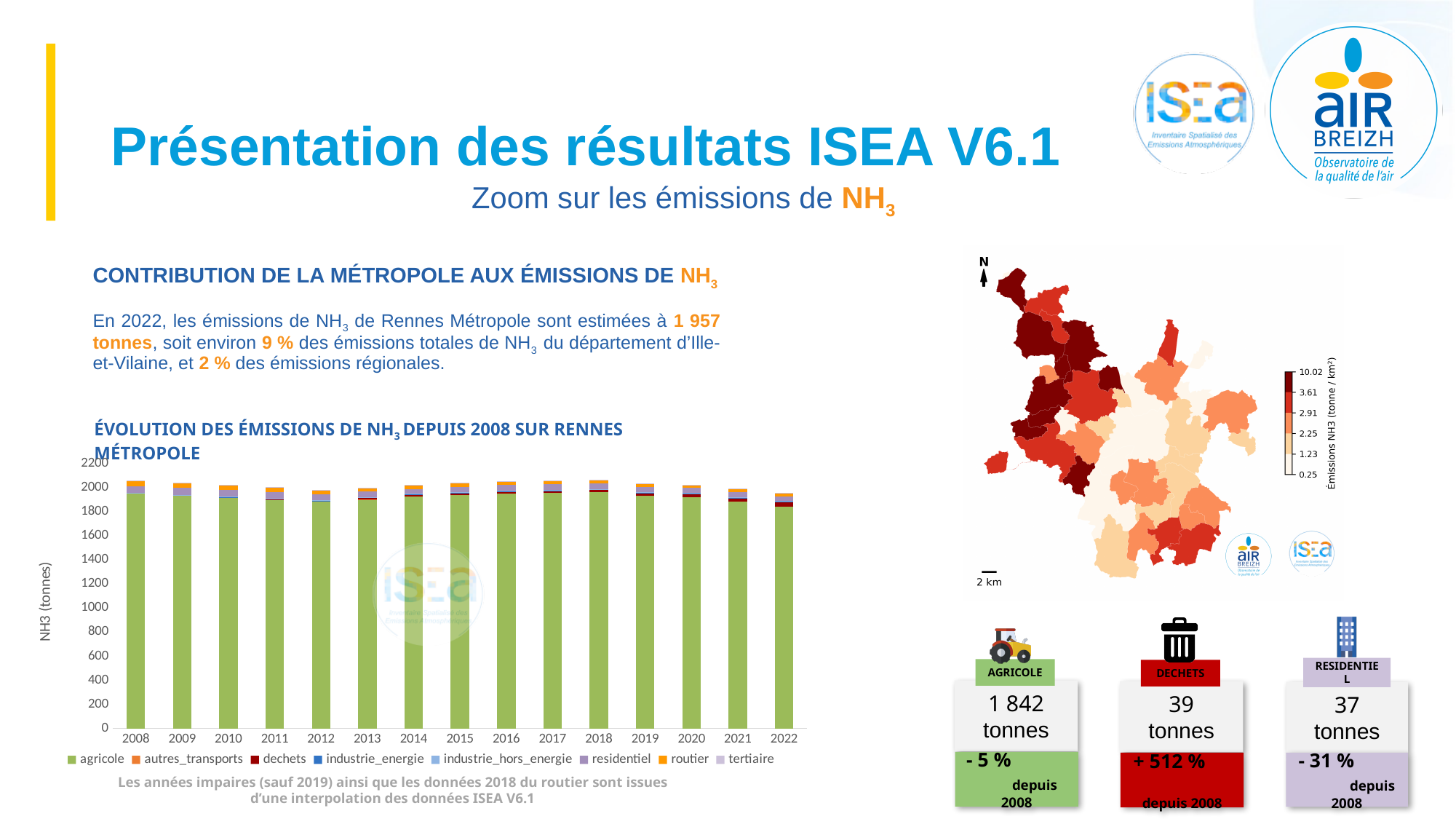
Which series makes up the largest part of each bar in the NH3 emissions evolution chart? agricole In the NH3 emissions evolution chart, is the agricole value for 2018 greater or less than 1400? greater In the NH3 emissions evolution chart, is the total for 2008 greater or less than 1800? greater How many years are shown on the x axis of the NH3 emissions evolution chart? 15 What is the label of the y axis of the NH3 emissions evolution chart? NH3 (tonnes) What is the highest tick value shown on the y axis of the NH3 emissions evolution chart? 2200 In the NH3 emissions evolution chart, is the total for 2022 greater or less than 2200? less What is the first year shown on the x axis of the NH3 emissions evolution chart? 2008 How many series does the legend of the NH3 emissions evolution chart list? 8 What kind of chart is used to show the evolution of NH3 emissions since 2008 on Rennes Métropole? Stacked bar chart